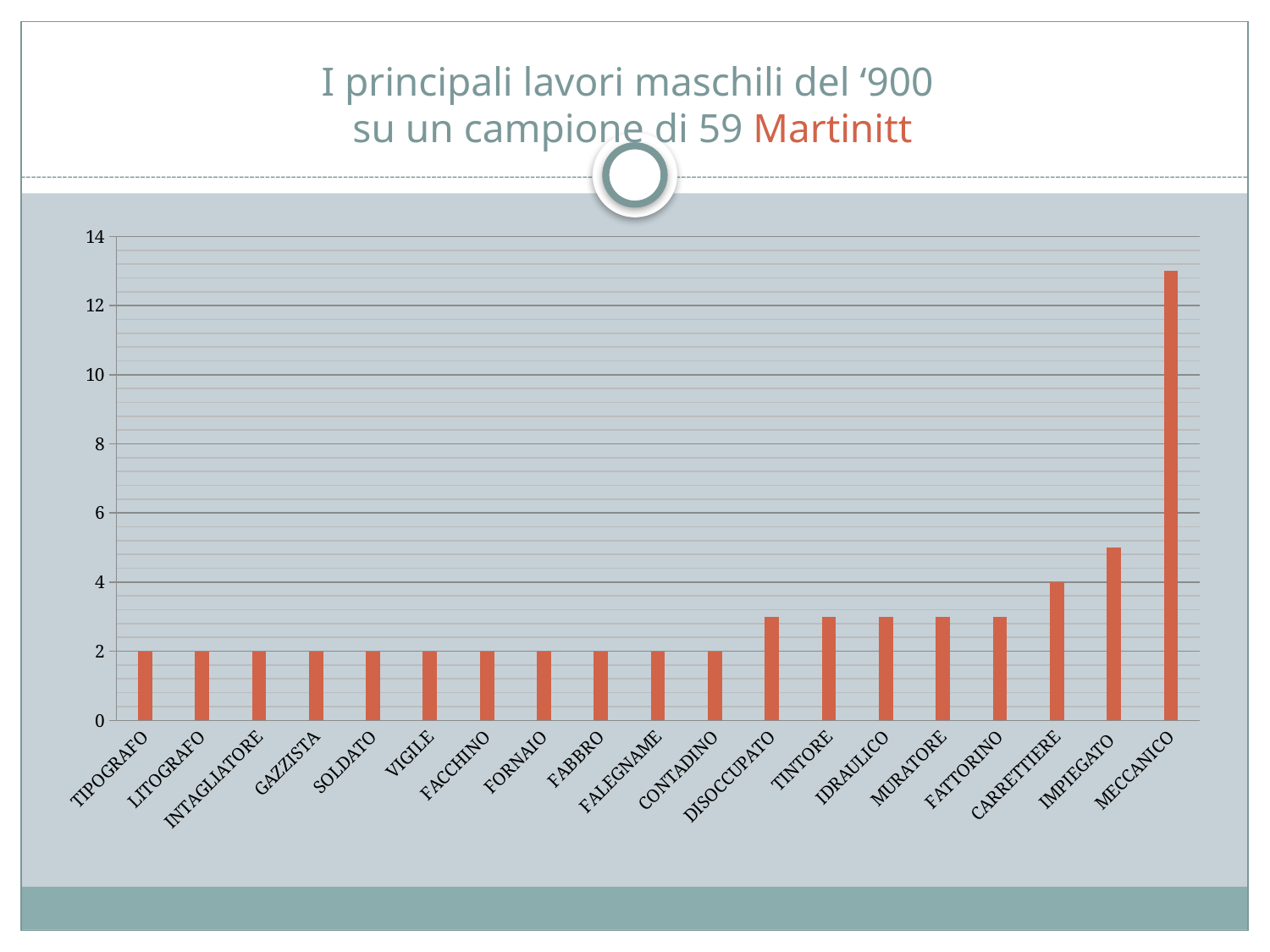
Is the value for MECCANICO greater or less than 12? greater Is the value for DISOCCUPATO greater or less than 4? less What is the value for CARRETTIERE? 4 Which is larger, the value for MECCANICO or the value for IMPIEGATO? MECCANICO What type of chart is shown on the slide? bar chart What is the difference between the value for CARRETTIERE and the value for TIPOGRAFO? 2 Which category has the highest value? MECCANICO What is the value for FALEGNAME? 2 What is the title of the slide containing the chart? I principali lavori maschili del '900 su un campione di 59 Martinitt What is the value for TIPOGRAFO? 2 Is the value for IMPIEGATO greater or less than 4? greater How many categories are shown on the x axis? 19